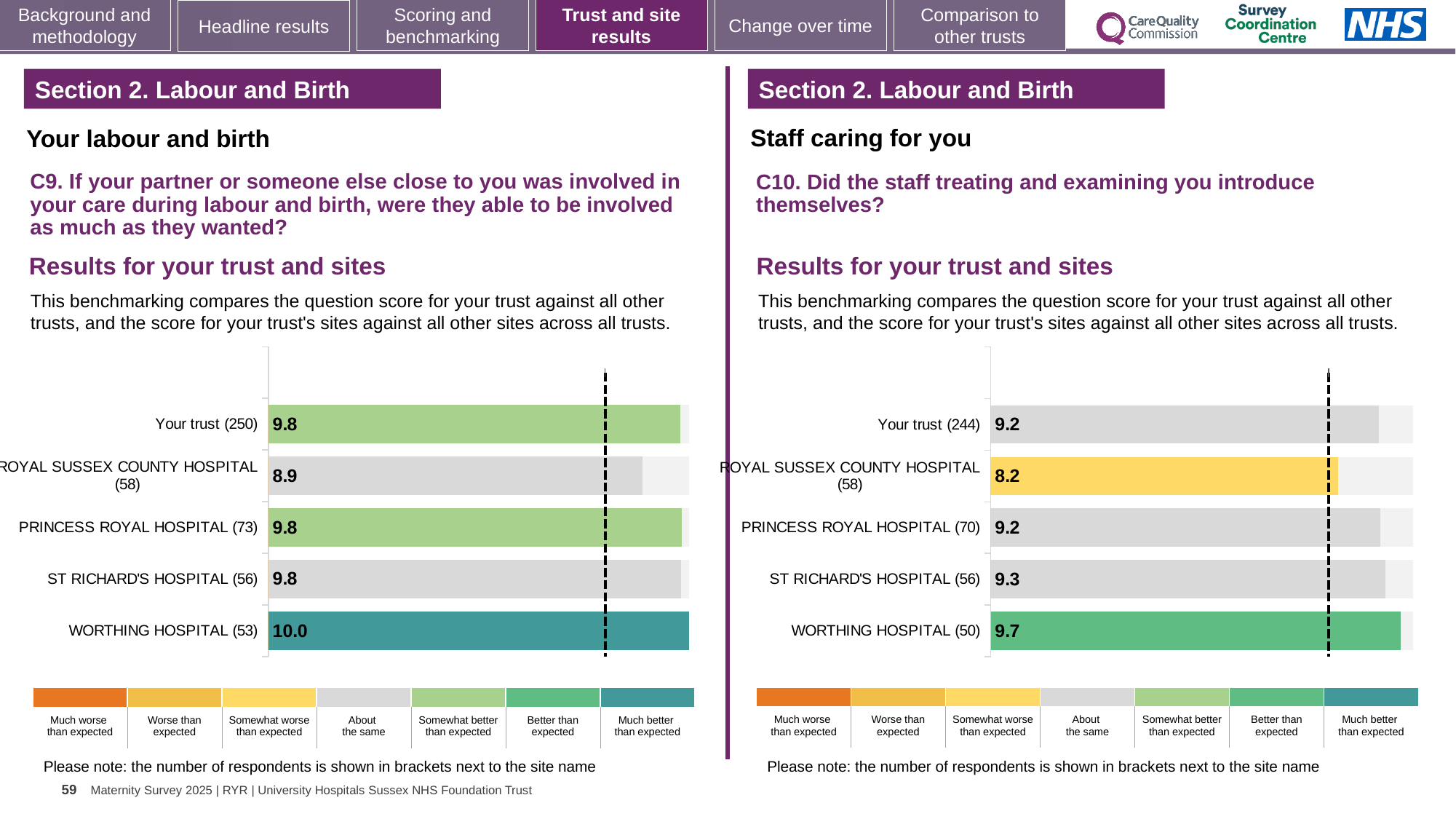
On the C10 chart (right), what is the score for St Richard's Hospital? 9.3 On the C9 chart (left), how many bars are plotted? 5 On the C9 chart (left), what is the difference between the scores for Worthing Hospital and Royal Sussex County Hospital? 1.1 On the C10 chart (right), what is the score for Your trust? 9.2 On the C9 chart (left), what is the score for Royal Sussex County Hospital? 8.9 What kind of chart is used on the C10 chart (right)? Bar chart On the C10 chart (right), which site has the lowest score? Royal Sussex County Hospital On the C9 chart (left), what is the score for Worthing Hospital? 10.0 On the C9 chart (left), which site has the lowest score? Royal Sussex County Hospital On the C10 chart (right), which is larger, the score for Worthing Hospital or the score for Princess Royal Hospital? Worthing Hospital On the C9 chart (left), which site has the highest score? Worthing Hospital On the C10 chart (right), what is the difference between the scores for Worthing Hospital and Royal Sussex County Hospital? 1.5